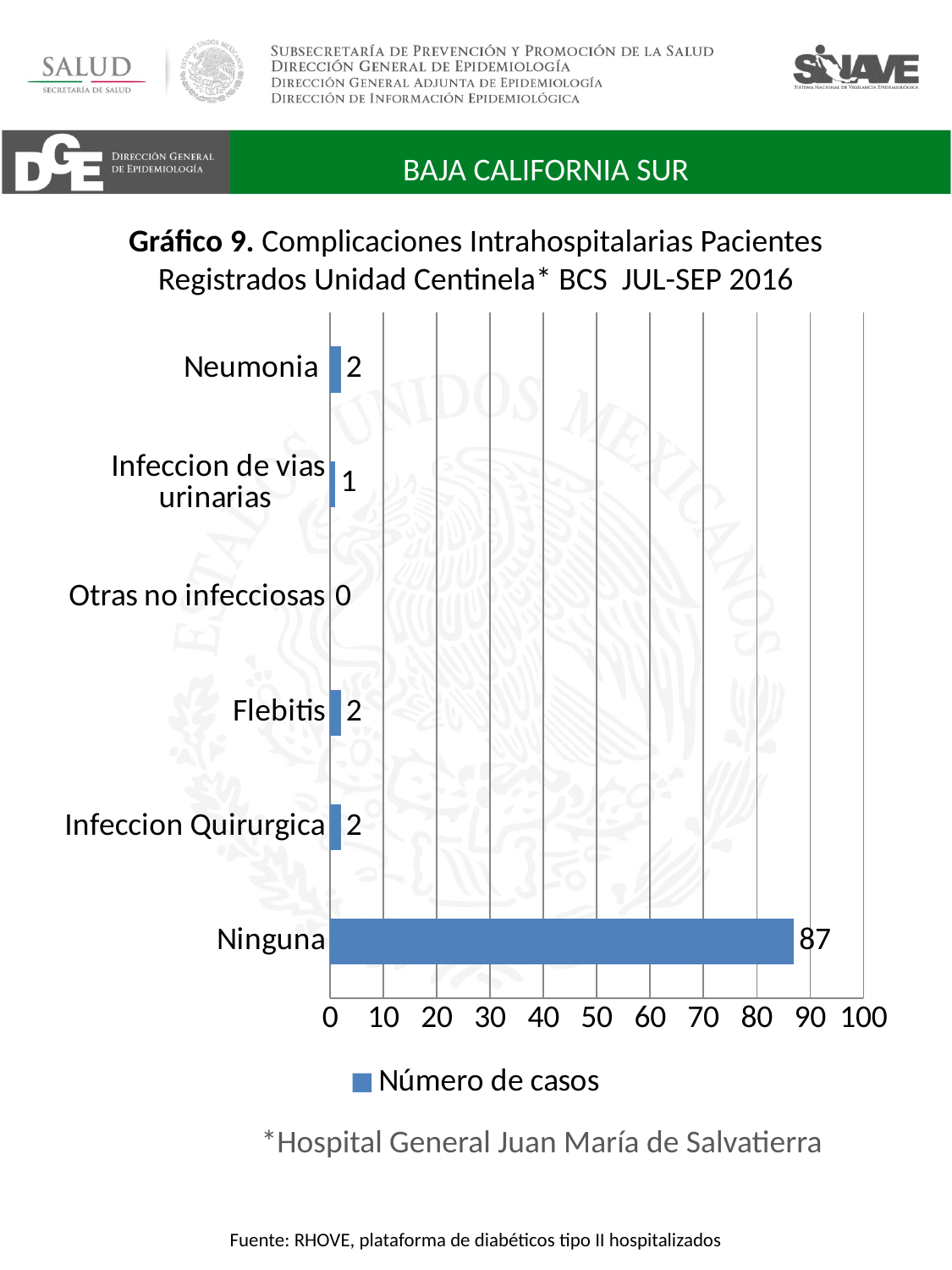
What is the number of cases for Ninguna? 87 What is the number of cases for Infeccion de vias urinarias? 1 What is the number of cases for Otras no infecciosas? 0 Which category has the lowest number of cases? Otras no infecciosas How many categories are shown on the chart? 6 Which category has the highest number of cases? Ninguna What is the difference between the number of cases for Ninguna and for Flebitis? 85 What series name does the legend show? Número de casos Is the value for Ninguna greater or less than 80? greater What kind of chart is shown on the slide? Bar chart Which has more cases, Neumonia or Infeccion de vias urinarias? Neumonia What is the number of cases for Neumonia? 2